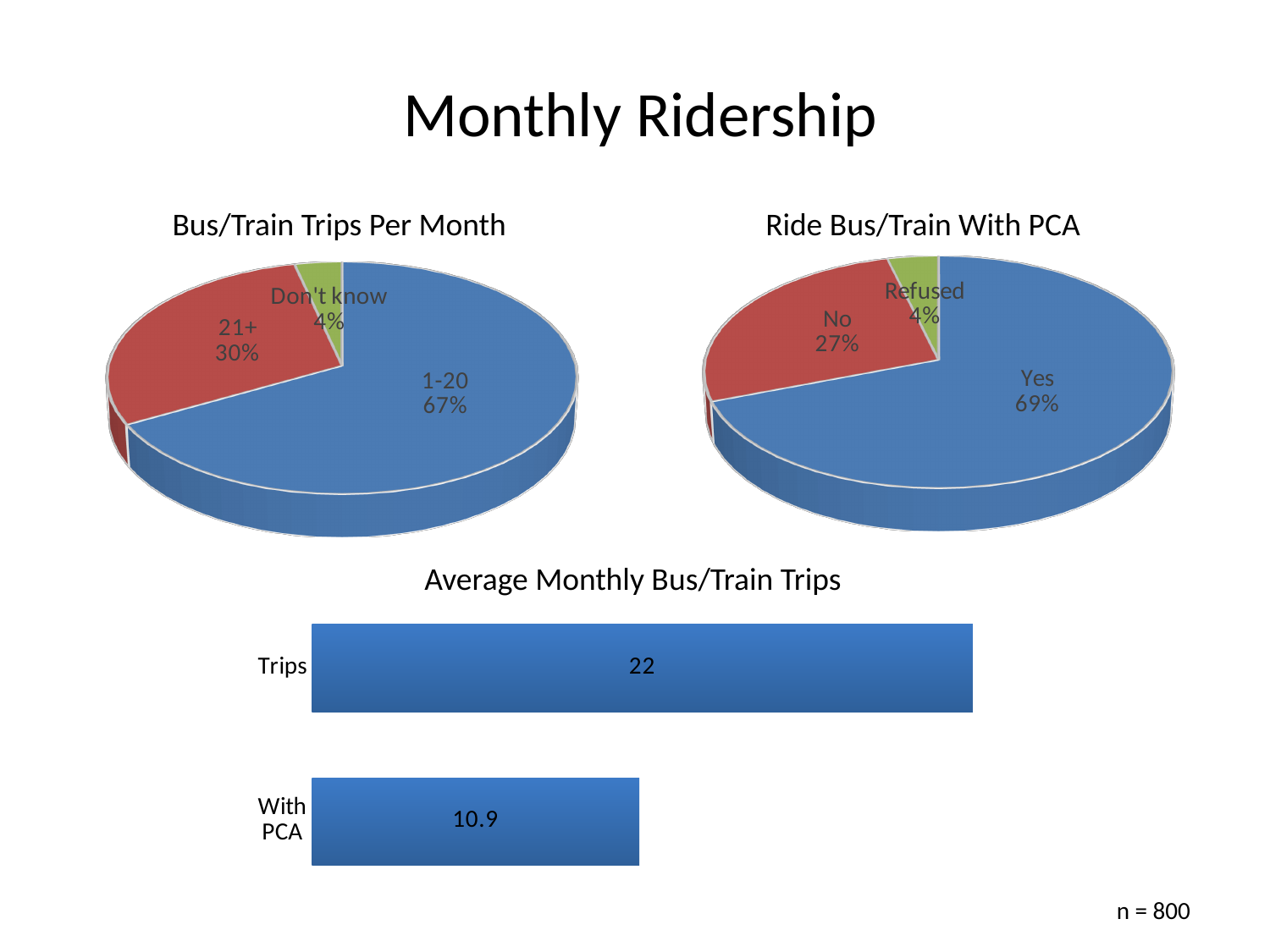
In the 'Average Monthly Bus/Train Trips' chart, what is the value for With PCA? 10.9 In the 'Ride Bus/Train With PCA' chart, what percentage is labelled Refused? 4% In the 'Bus/Train Trips Per Month' chart, how many slices does the pie have? 3 In the 'Bus/Train Trips Per Month' chart, what percentage is shown for 21+? 30% In the 'Average Monthly Bus/Train Trips' chart, what is the difference between Trips and With PCA? 11.1 In the 'Bus/Train Trips Per Month' chart, what share of respondents take 1-20 trips? 67% In the 'Ride Bus/Train With PCA' chart, what is the difference between the Yes and No shares? 42% In the 'Bus/Train Trips Per Month' chart, which category has the smallest slice? Don't know In the 'Ride Bus/Train With PCA' chart, which category has the largest slice? Yes In the 'Ride Bus/Train With PCA' chart, what percentage answered Yes? 69% What kind of chart is 'Average Monthly Bus/Train Trips'? Bar chart In the 'Average Monthly Bus/Train Trips' chart, which is larger, Trips or With PCA? Trips